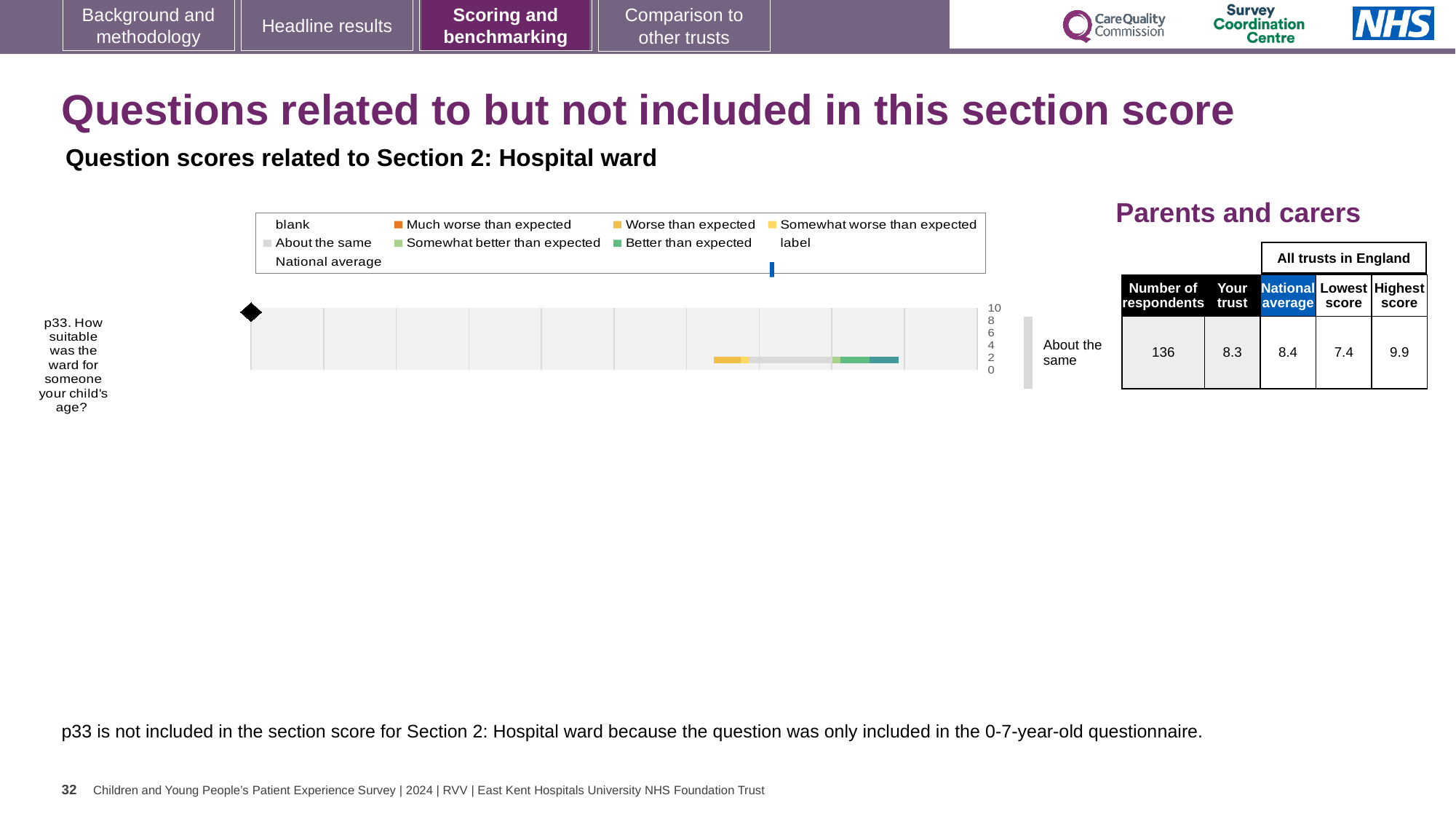
What is the highest score among all trusts in England for p33? 9.9 What kind of chart is used to show the p33 question score? bar chart What is the 'Your trust' score for p33 (How suitable was the ward for someone your child's age?)? 8.3 How many questions are plotted in the chart? 1 What colour does the legend use for 'Much worse than expected'? Orange What benchmark category label is shown next to the p33 bar? About the same Which is larger for p33: the 'Your trust' score or the national average? National average How many respondents answered p33? 136 What is the difference between the highest score and the lowest score for p33? 2.5 What is the national average score for p33? 8.4 What is the difference between the national average and the 'Your trust' score for p33? 0.1 What is the lowest score among all trusts in England for p33? 7.4